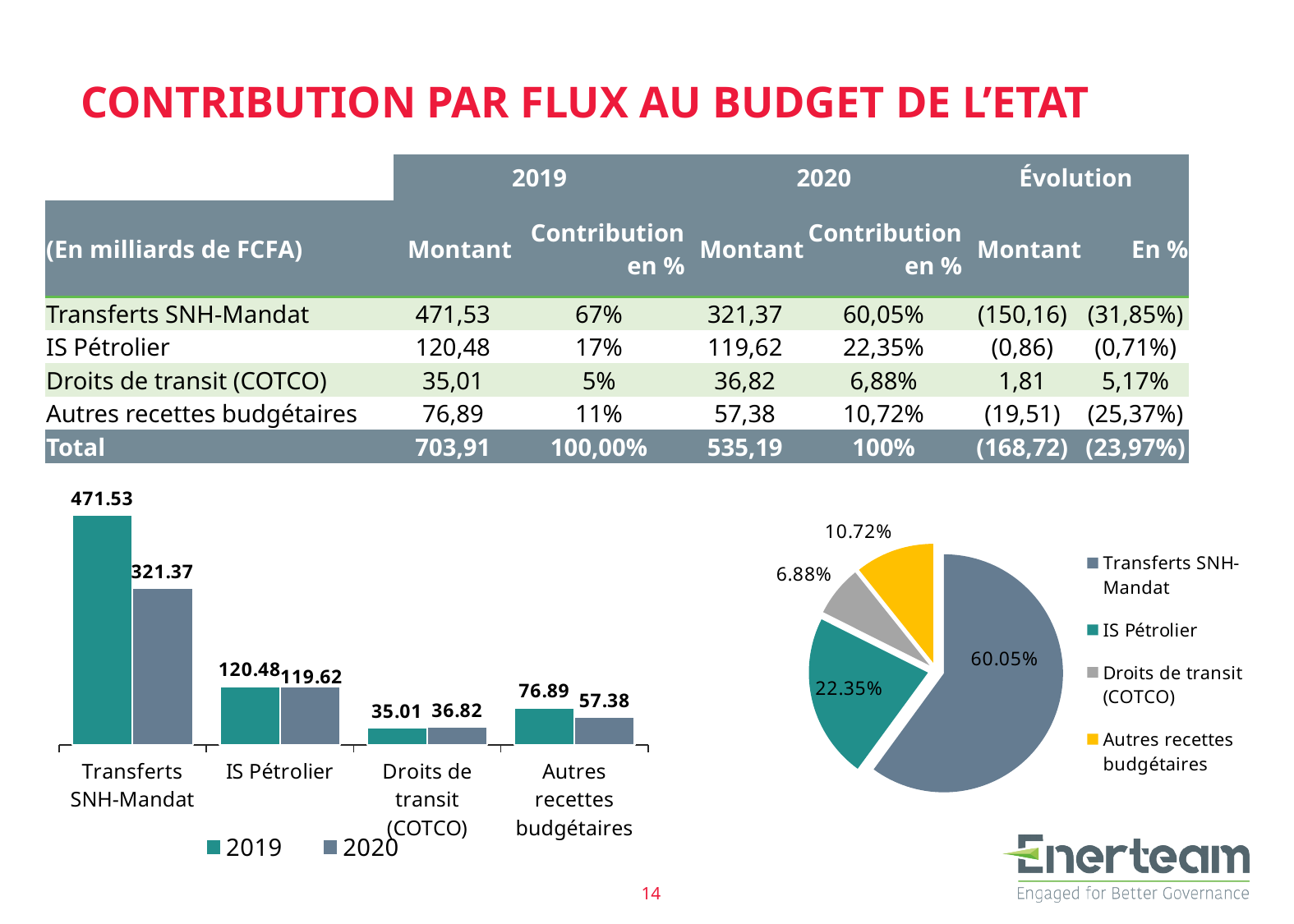
In the bar chart on the left, what is the difference between the 2019 and 2020 values for Transferts SNH-Mandat? 150.16 What kind of chart is shown on the bottom left of the slide? Bar chart In the pie chart on the right, which category has the smallest slice? Droits de transit (COTCO) In the bar chart on the left, which category has the highest 2019 value? Transferts SNH-Mandat How many slices does the pie chart on the right have? 4 In the bar chart on the left, what is the 2019 value for Transferts SNH-Mandat? 471.53 In the bar chart on the left, which category has the lowest 2020 value? Droits de transit (COTCO) In the bar chart on the left, what is the 2020 value for IS Pétrolier? 119.62 How many series does the legend of the bar chart on the left list? 2 In the bar chart on the left, is the 2019 or the 2020 value larger for Droits de transit (COTCO)? 2020 In the bar chart on the left, what is the 2020 value for Droits de transit (COTCO)? 36.82 In the pie chart on the right, what share does IS Pétrolier have? 22.35%